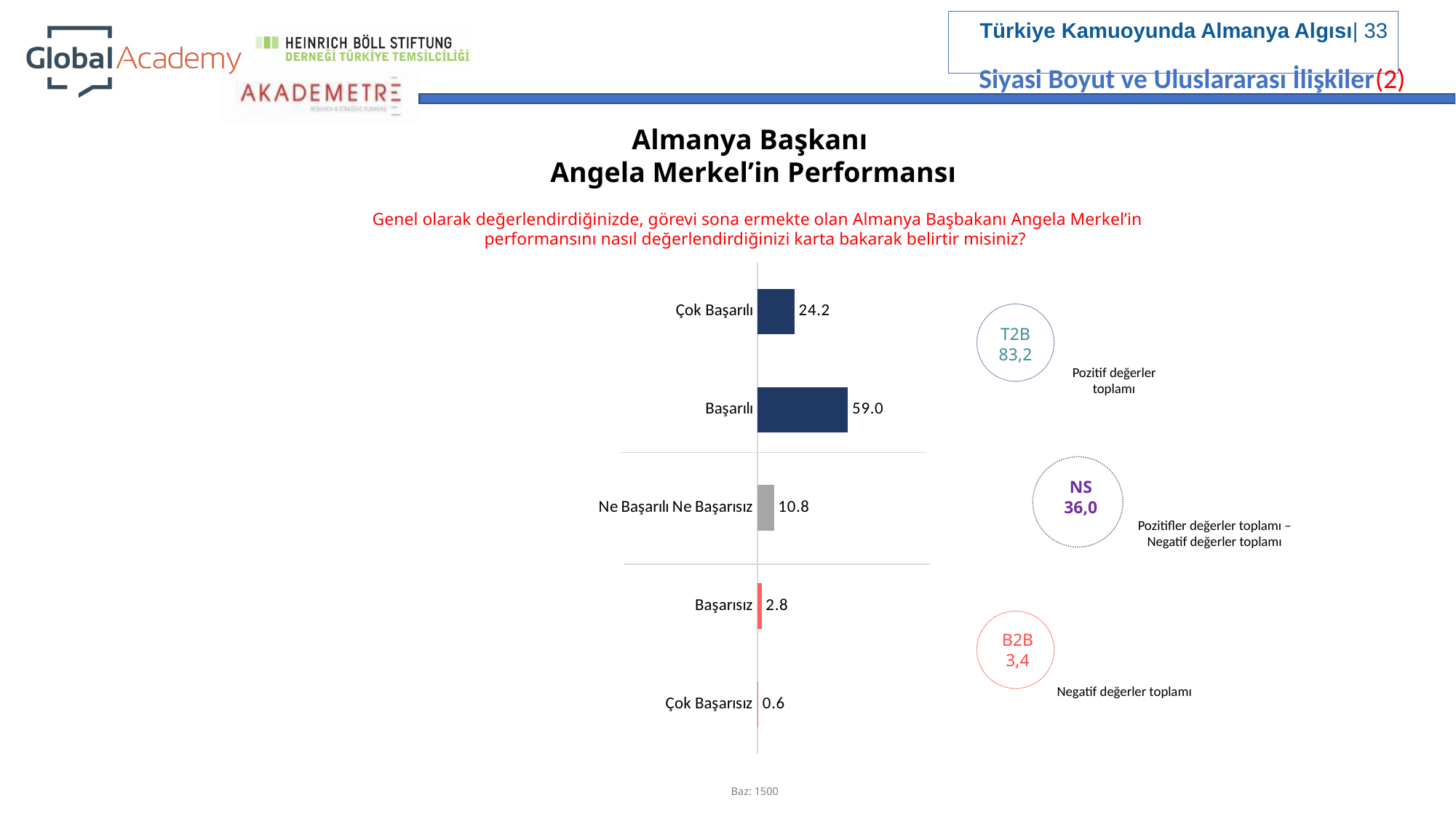
How many categories are shown in the bar chart? 5 What is the value for Çok Başarılı? 24.2 Which is larger, the value for Ne Başarılı Ne Başarısız or the value for Başarısız? Ne Başarılı Ne Başarısız What is the B2B (Negatif değerler toplamı) value shown next to the chart? 3,4 What kind of chart is shown on the slide? Bar chart What is the difference between the values for Başarılı and Çok Başarılı? 34.8 Which category has the lowest value? Çok Başarısız What is the value for Başarılı? 59.0 What is the value for Çok Başarısız? 0.6 Which category has the highest value? Başarılı What is the T2B (Pozitif değerler toplamı) value shown next to the chart? 83,2 What is the value for Ne Başarılı Ne Başarısız? 10.8